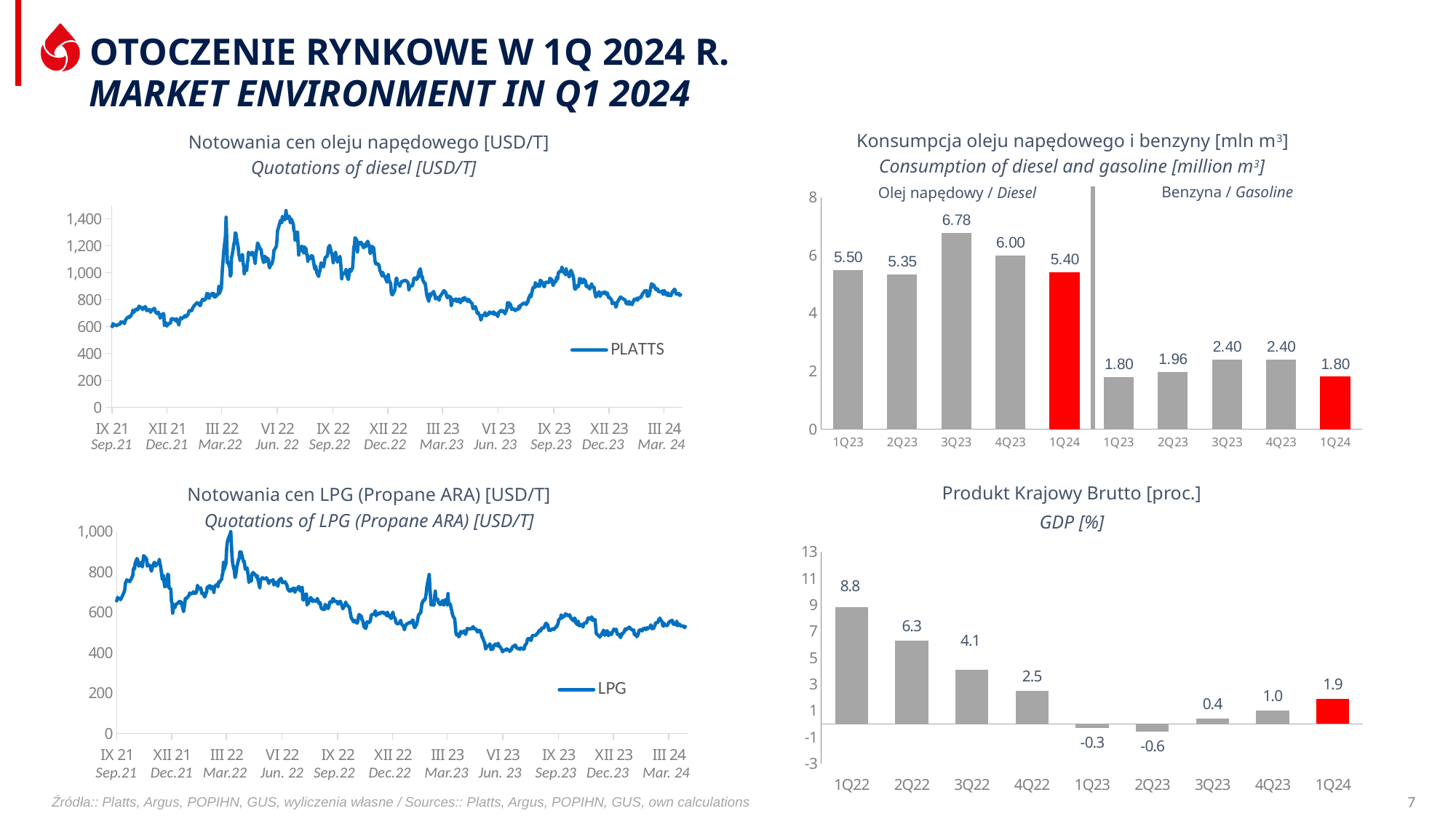
In the 'Consumption of diesel and gasoline' chart, what is the difference between diesel consumption in 4Q23 and 1Q24? 0.60 In the 'GDP [%]' chart, which quarter has the lowest value? 2Q23 In the 'Consumption of diesel and gasoline' chart, which quarter has the highest diesel consumption? 3Q23 In the 'Consumption of diesel and gasoline' chart, what is the diesel consumption value for 3Q23? 6.78 In the 'GDP [%]' chart, what is the value for 1Q22? 8.8 In the 'GDP [%]' chart, is the value for 3Q22 larger or smaller than the value for 4Q22? larger In the 'Quotations of LPG (Propane ARA) [USD/T]' chart, is the value at Mar. 24 greater or less than 600? less In the 'GDP [%]' chart, how many quarters are shown on the x axis? 9 In the 'GDP [%]' chart, what is the difference between the values for 4Q23 and 1Q24? 0.9 What kind of chart is the 'Quotations of diesel [USD/T]' chart? line chart In the 'Consumption of diesel and gasoline' chart, what is the gasoline consumption value for 2Q23? 1.96 What series name does the legend of the 'Quotations of diesel [USD/T]' chart show? PLATTS